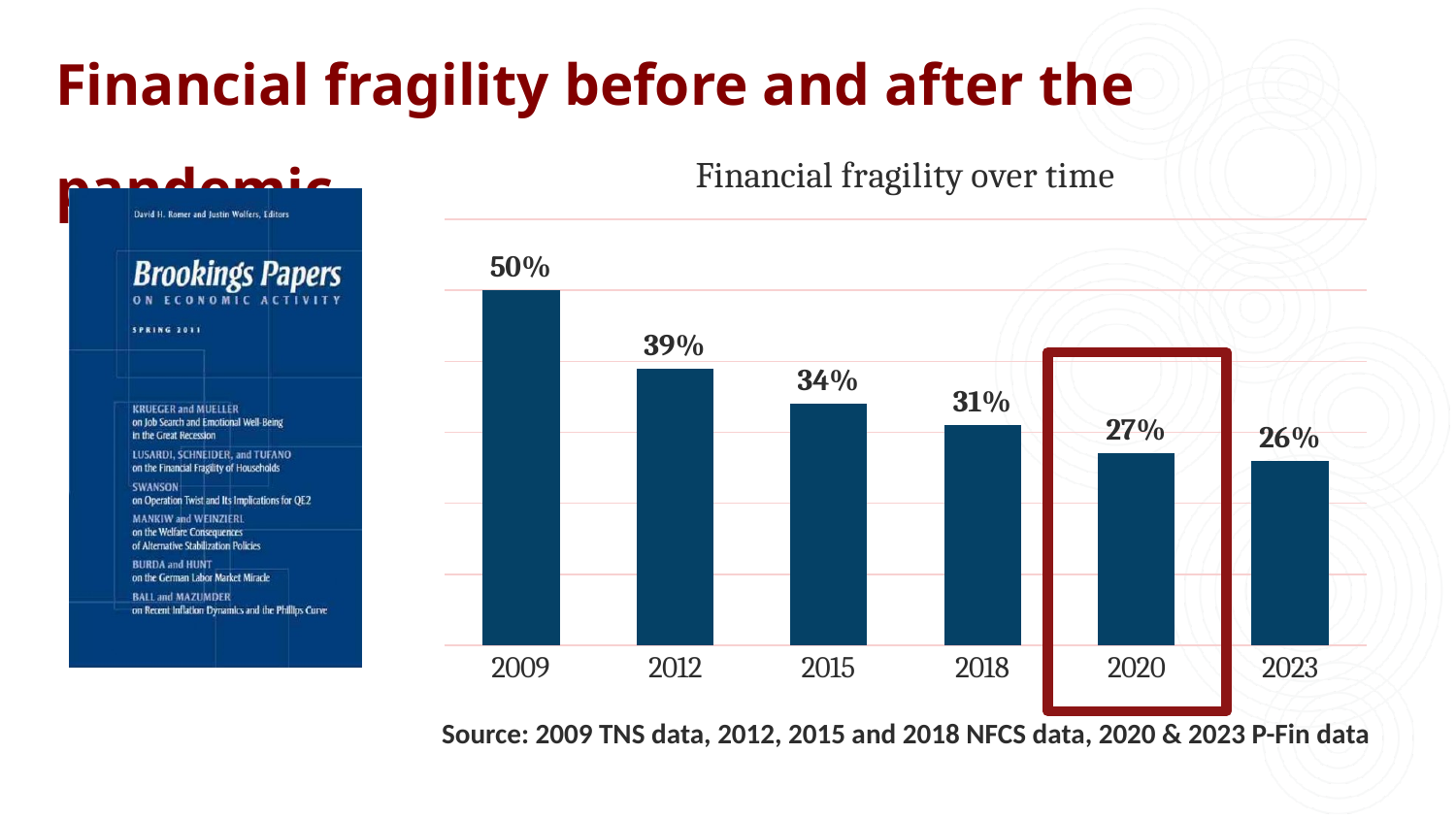
Do the values in the Financial fragility over time chart rise or fall from 2009 to 2023? Fall How many years are shown in the Financial fragility over time chart? 6 What is the value for 2015 in the Financial fragility over time chart? 34% What kind of chart is the Financial fragility over time chart? Bar chart Which is larger in the Financial fragility over time chart, the value for 2012 or the value for 2018? 2012 What is the value for 2009 in the Financial fragility over time chart? 50% Which year has the lowest value in the Financial fragility over time chart? 2023 What is the value for 2023 in the Financial fragility over time chart? 26% Which year has the highest value in the Financial fragility over time chart? 2009 What is the difference between the values for 2009 and 2012 in the Financial fragility over time chart? 11% What is the value for 2020 in the Financial fragility over time chart? 27% What is the difference between the values for 2018 and 2020 in the Financial fragility over time chart? 4%